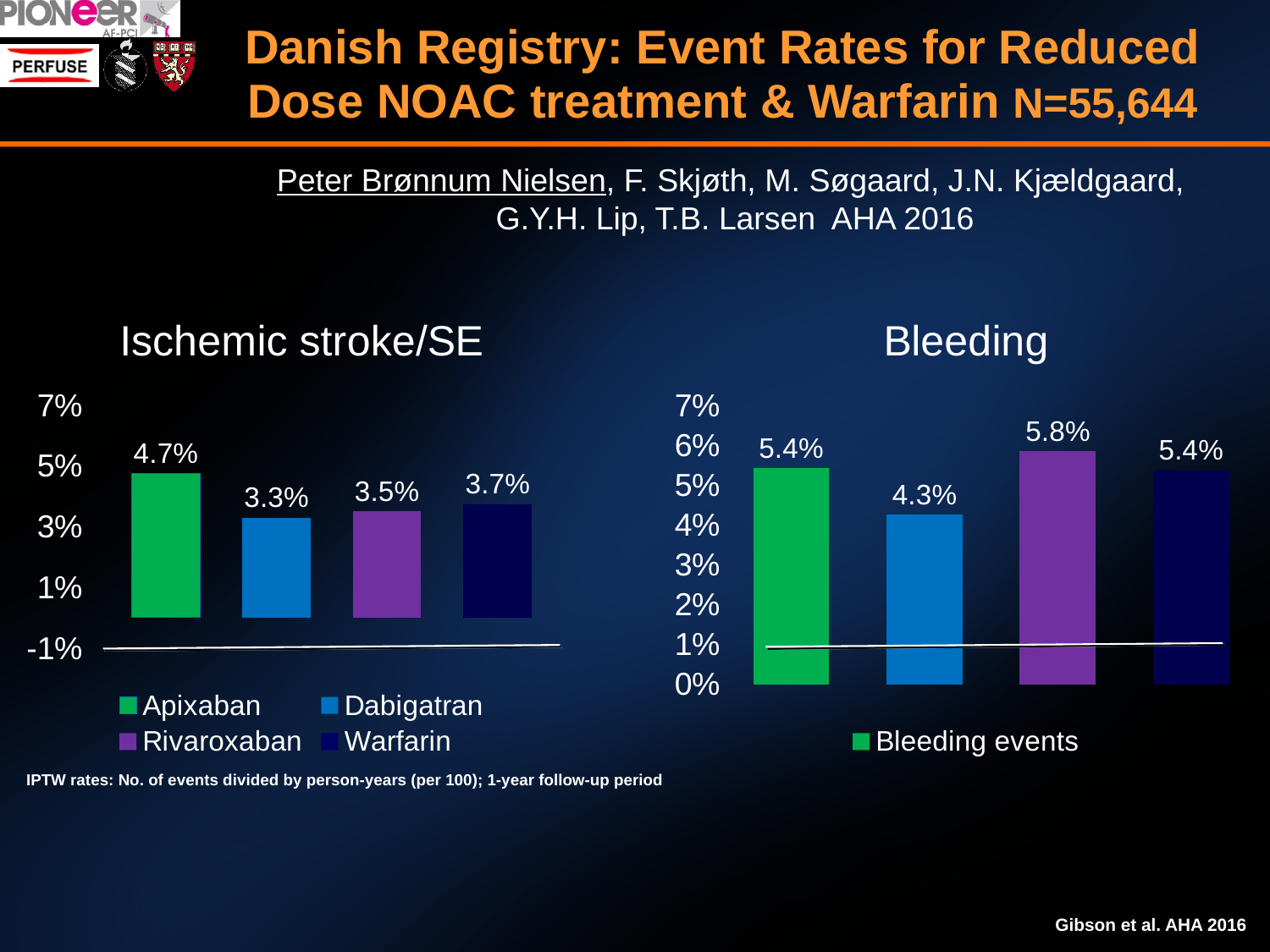
In the Ischemic stroke/SE chart, which is larger, the value for Rivaroxaban or the value for Warfarin? Warfarin In the Bleeding chart, what is the value shown on the second bar from the left? 4.3% In the Ischemic stroke/SE chart, which drug has the highest event rate? Apixaban In the Ischemic stroke/SE chart, what is the value for Apixaban? 4.7% How many entries does the legend of the Ischemic stroke/SE chart list? 4 In the Bleeding chart, what is the difference between the highest and lowest bar values? 1.5% In the Ischemic stroke/SE chart, what is the difference between the Apixaban and Dabigatran values? 1.4% In the Ischemic stroke/SE chart, what is the value for Warfarin? 3.7% In the Ischemic stroke/SE chart, which drug has the lowest event rate? Dabigatran What kind of chart is the Bleeding chart? Bar chart In the Bleeding chart, what is the value shown on the tallest bar? 5.8% In the Ischemic stroke/SE chart, what is the value for Dabigatran? 3.3%